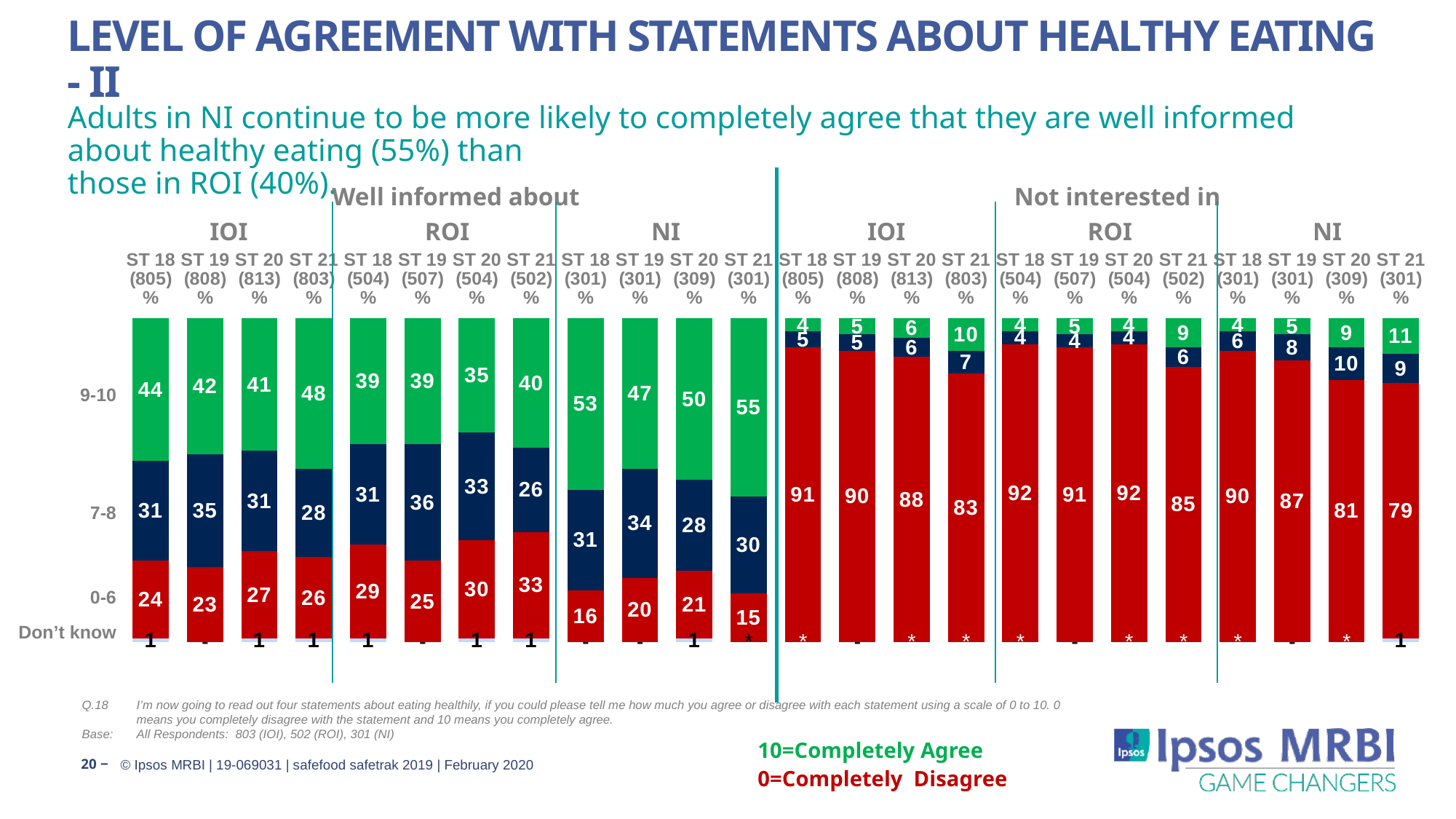
In the 'Well informed about' section, what percentage of ROI adults gave a 0-6 rating in ST 21? 33 In the 'Not interested in' section, what percentage of NI adults gave a 7-8 rating in ST 20? 10 How many bars are plotted on the chart in total? 24 In the 'Not interested in' section, do the 0-6 percentages for NI rise or fall from ST 18 to ST 21? fall In the 'Not interested in' section, which bar has the lowest 0-6 percentage? NI ST 21 What kind of chart is shown on the slide? stacked bar chart In the 'Not interested in' section, what percentage of IOI adults gave a 0-6 rating in ST 21? 83 In the 'Well informed about' section, which is larger: the 7-8 percentage for ROI in ST 19 or for IOI in ST 19? ROI ST 19 What colour represents the 9-10 rating band in the chart? green In the 'Well informed about' section, which bar has the highest 9-10 percentage? NI ST 21 In the 'Well informed about' section, what percentage of NI adults gave a 9-10 rating in ST 21? 55 In the 'Well informed about' section, what is the difference between the 9-10 percentage for NI in ST 21 and for ROI in ST 21? 15